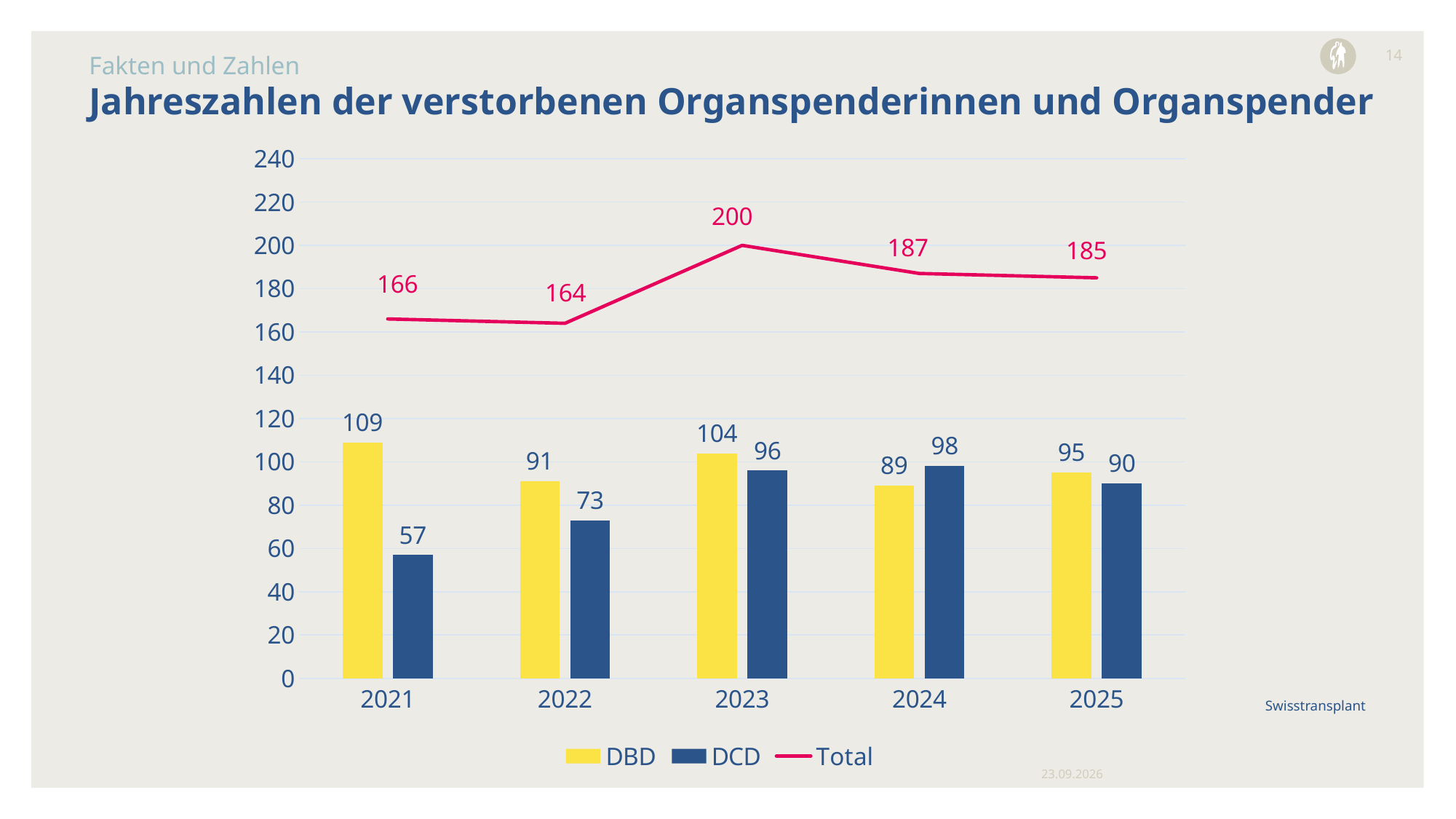
What colour are the DBD bars? yellow How many series does the legend list? 3 What is the difference between the DBD and DCD values in 2021? 52 How many years are shown on the x axis? 5 Is the Total value for 2022 greater or less than 180? less Which year has the highest Total value? 2023 What is the DCD value for 2022? 73 Which year has the lowest DCD value? 2021 Does the DCD value rise or fall from 2021 to 2022? rise Which is larger in 2024, the DBD value or the DCD value? DCD What is the Total value for 2023? 200 What is the DBD value for 2021? 109